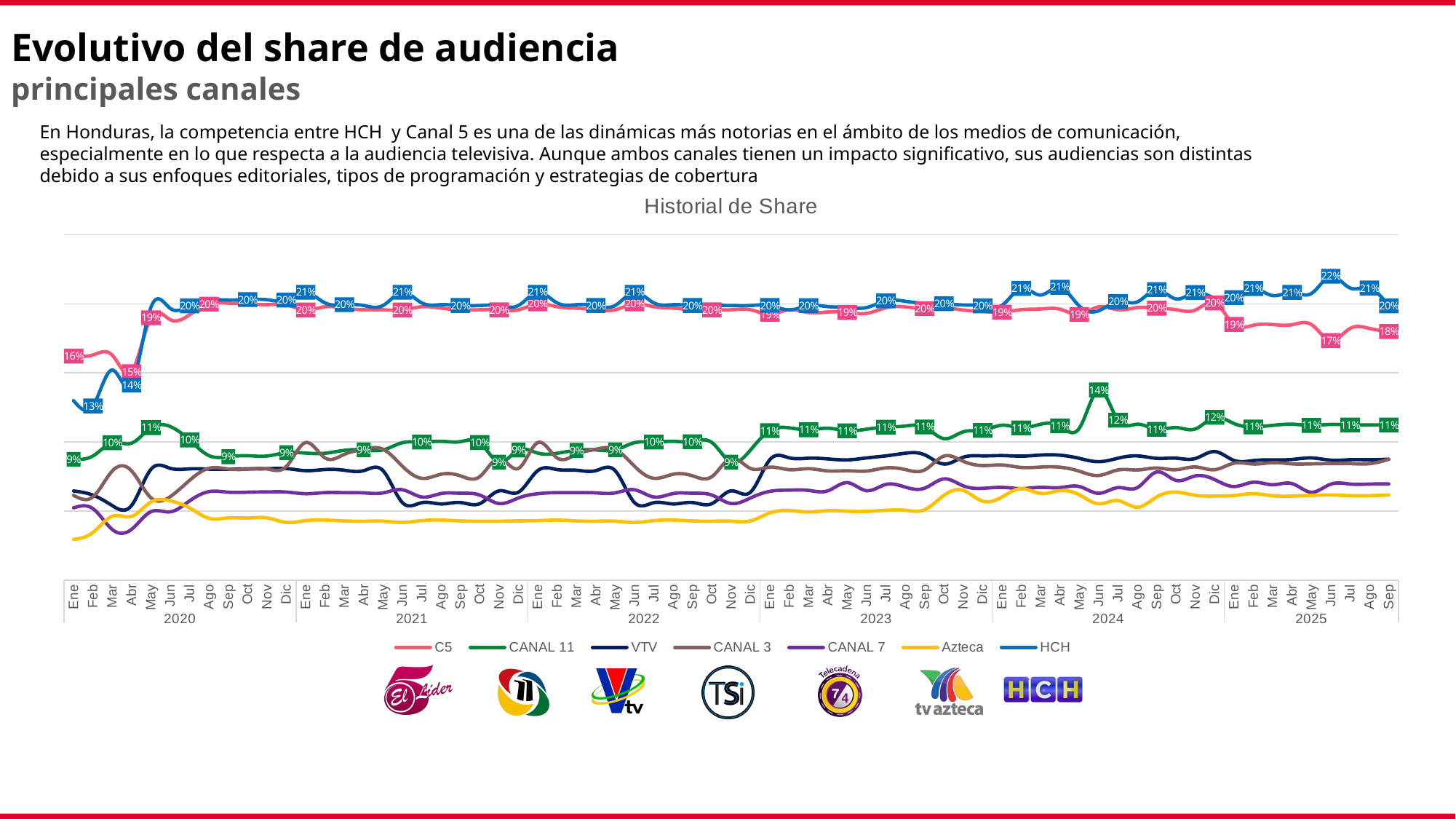
What kind of chart is the 'Historial de Share' chart? line chart What is the difference between the HCH share and the C5 share in Sep 2025? 2 percentage points What is the share value for HCH in Feb 2020? 13% How many series does the legend of the 'Historial de Share' chart list? 7 What is the share value for HCH in Sep 2025? 20% In Sep 2025, which has the higher share, HCH or C5? HCH What is the share value for C5 in Sep 2025? 18% What is the share value for CANAL 11 in Jun 2024? 14% What is the share value for HCH in Jun 2025? 22% What is the title of the chart? Historial de Share What is the share value for C5 in Ene 2020? 16% What is the share value for CANAL 11 in Sep 2025? 11%